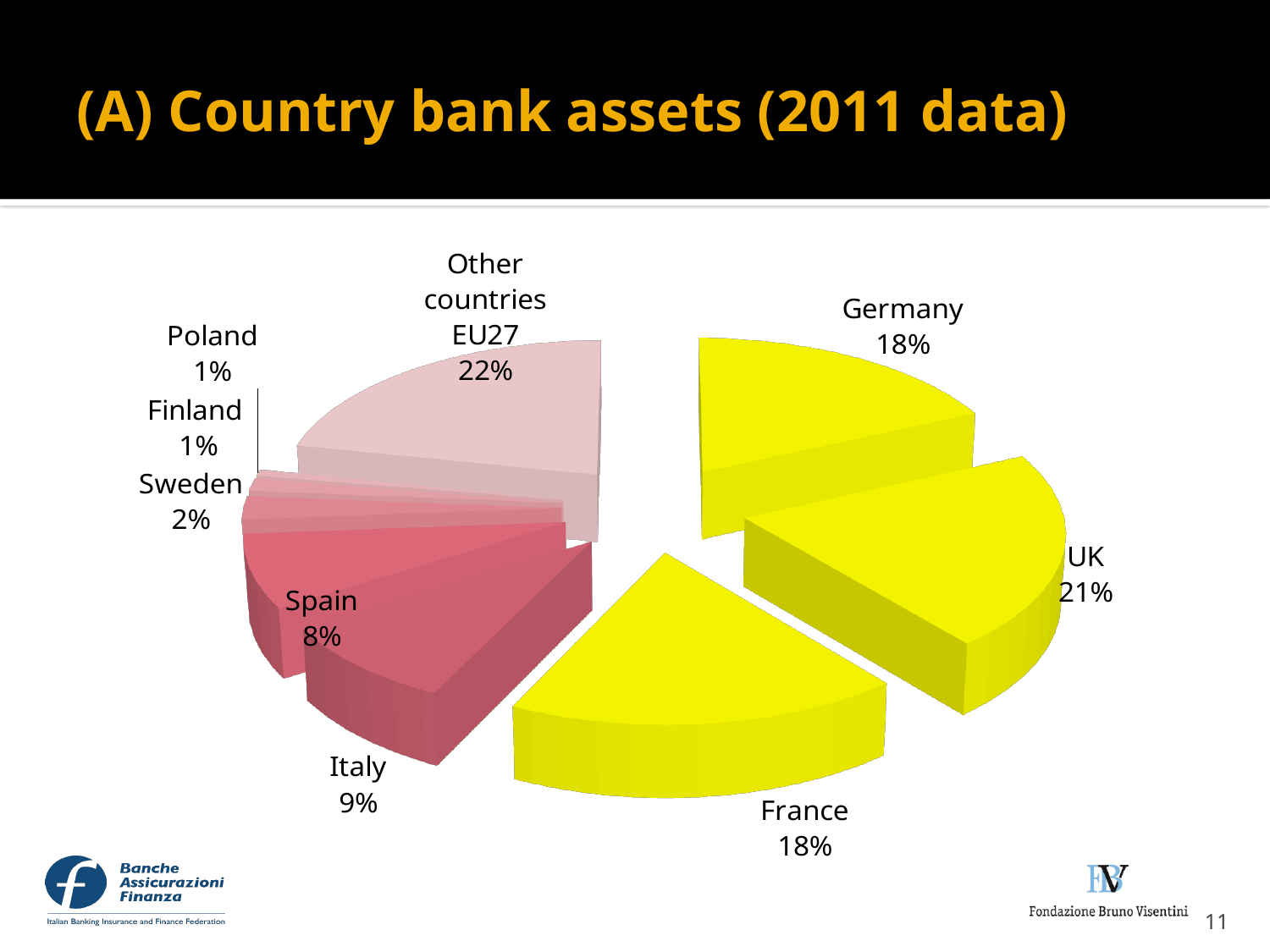
What is the title of the slide? (A) Country bank assets (2011 data) What is the difference between the UK's share and Italy's share? 12% What share of bank assets does Germany hold? 18% What kind of chart is shown on the slide? pie chart What share of bank assets does Spain hold? 8% What share of bank assets does Italy hold? 9% How many slices does the pie chart have? 9 What share of bank assets does the UK hold? 21% What share of bank assets does Sweden hold? 2% Which has a larger share of bank assets, Spain or Italy? Italy Which slice of the pie is the largest? Other countries EU27 Which individual country has the largest share of bank assets? UK